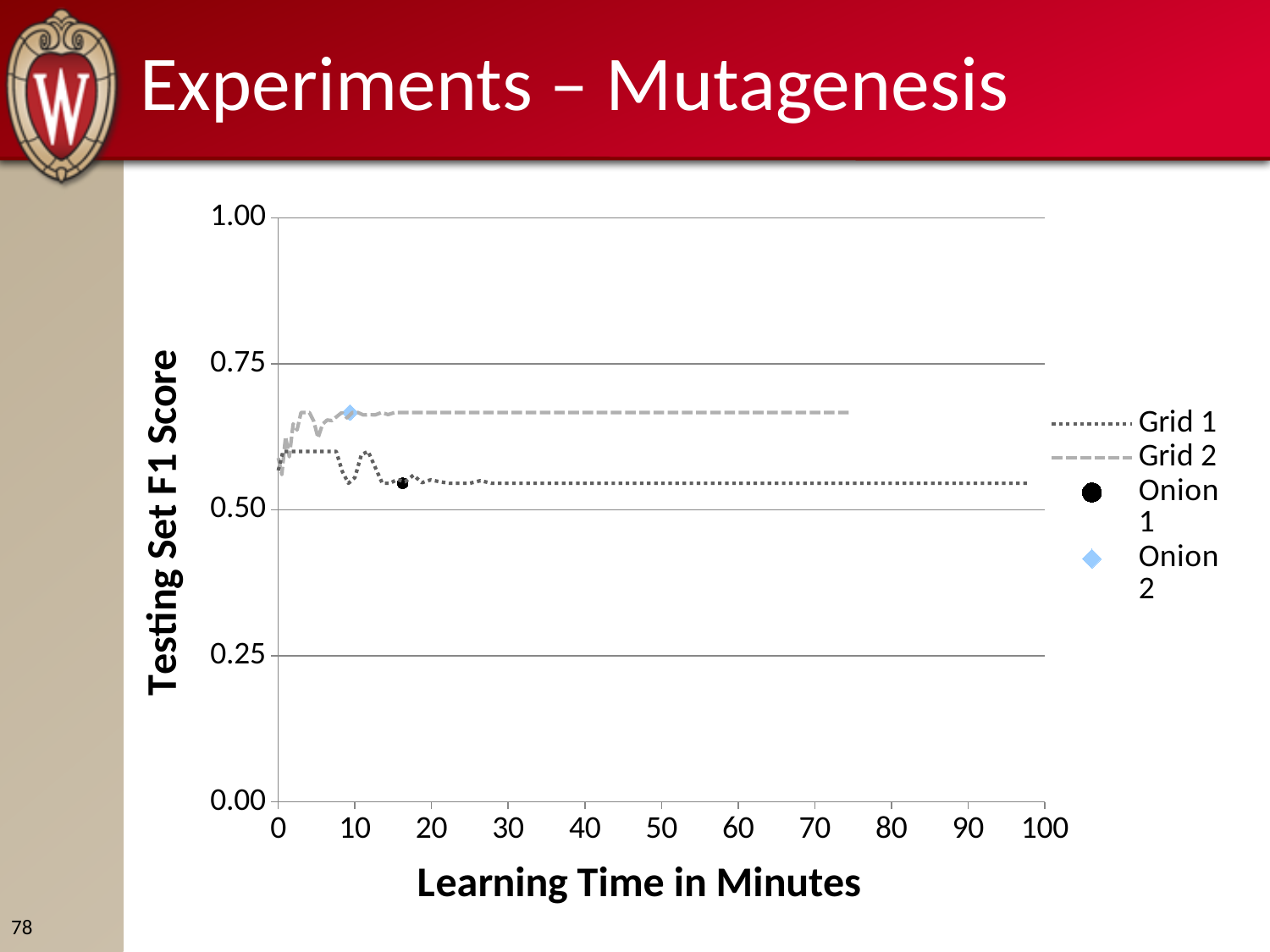
Which marker has the higher Testing Set F1 Score, Onion 1 or Onion 2? Onion 2 What kind of chart is shown on the slide? line chart Is the Grid 2 value at 50 minutes greater or less than 0.50? greater What are the series names listed in the legend? Grid 1, Grid 2, Onion 1, Onion 2 Is the Grid 1 value at 50 minutes greater or less than 0.75? less Which of the two lines, Grid 1 or Grid 2, has the lower Testing Set F1 Score over most of the learning time? Grid 1 At 50 minutes of learning time, which series has the higher Testing Set F1 Score, Grid 1 or Grid 2? Grid 2 How many series does the legend list? 4 Is the Onion 2 marker greater or less than 0.75 on the Testing Set F1 Score axis? less What is the title of the vertical axis? Testing Set F1 Score Which line extends further along the Learning Time in Minutes axis, Grid 1 or Grid 2? Grid 1